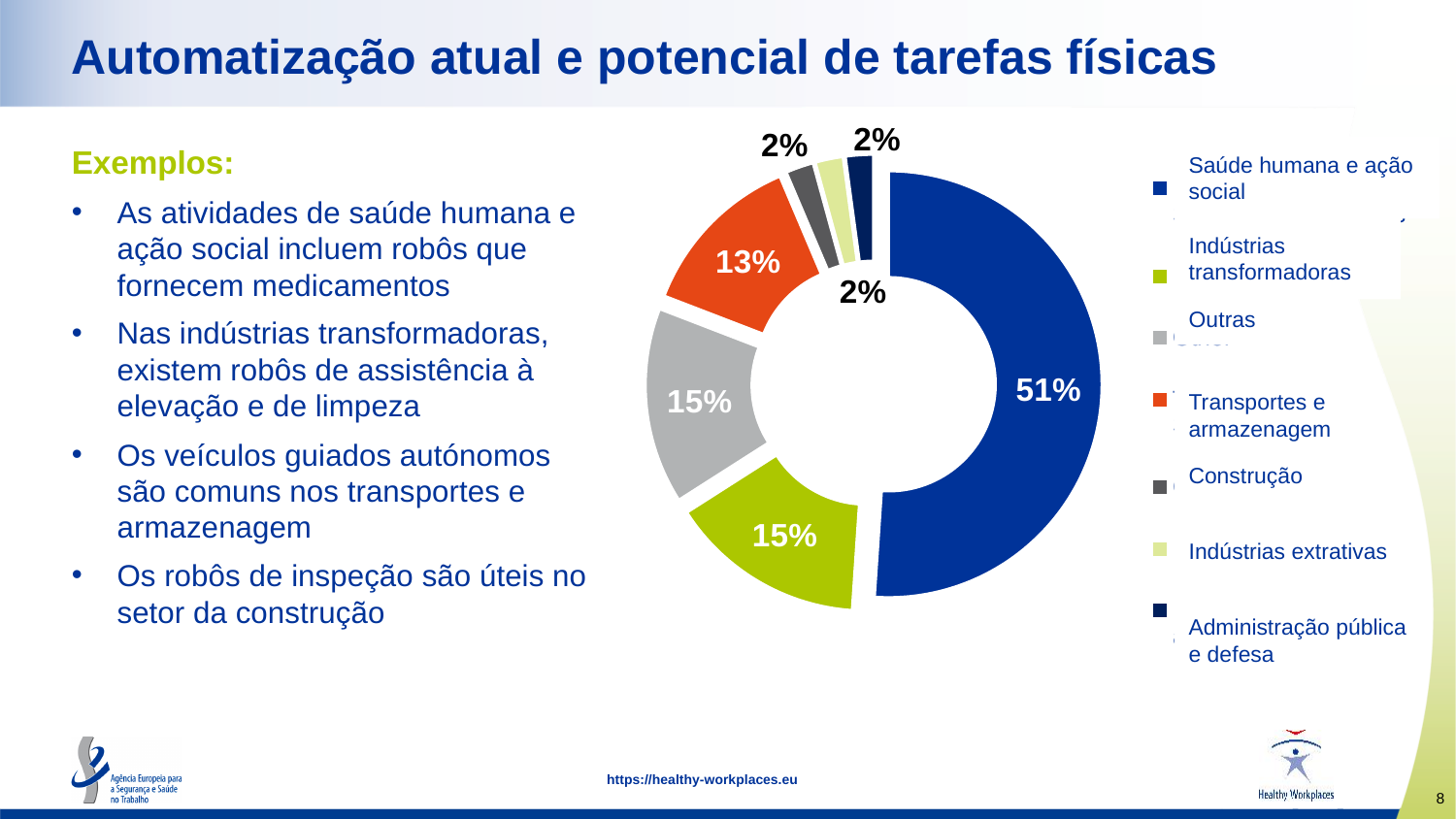
What percentage is shown for Indústrias transformadoras? 15% What is the smallest percentage value shown on the chart? 2% How many categories does the legend list? 7 Is the share for Saúde humana e ação social greater or less than 50%? greater What is the difference in percentage points between Saúde humana e ação social and Transportes e armazenagem? 38 percentage points What percentage is shown for Transportes e armazenagem? 13% What kind of chart is shown on the slide? doughnut chart What percentage is shown for Construção? 2% Which is larger, the share for Outras or the share for Transportes e armazenagem? Outras What percentage is shown for Saúde humana e ação social? 51% Which category has the largest share of the chart? Saúde humana e ação social Which legend entry is shown in orange? Transportes e armazenagem